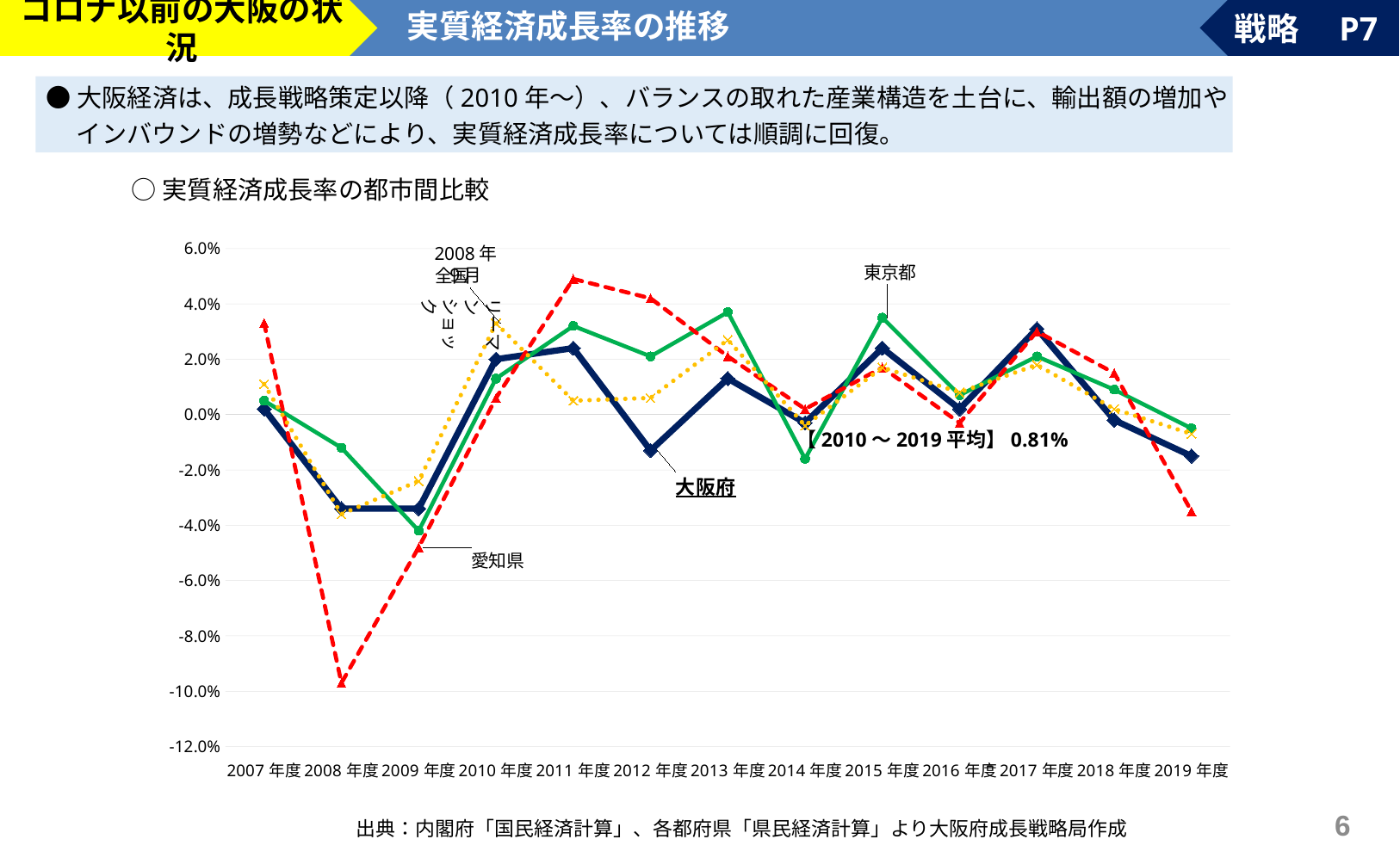
How many fiscal years are plotted along the x axis? 13 In which fiscal year does the 愛知県 line reach its lowest value? 2008年度 Does the 大阪府 line rise or fall from 2017年度 to 2019年度? fall What kind of chart is shown on the slide? line chart Is the value for 東京都 in 2013年度 greater or less than 2.0%? greater Is the value for 愛知県 in 2008年度 greater or less than -8.0%? less In which fiscal year does the 大阪府 line reach its highest value? 2017年度 What is the title of the chart section on the slide? 実質経済成長率の都市間比較 Is the value for 大阪府 in 2019年度 greater or less than 0.0%? less What is the 2010–2019 average growth rate printed on the chart? 0.81% In which fiscal year does the 愛知県 line reach its highest value? 2011年度 In 2008年度, which is higher, the value for 大阪府 or the value for 愛知県? 大阪府